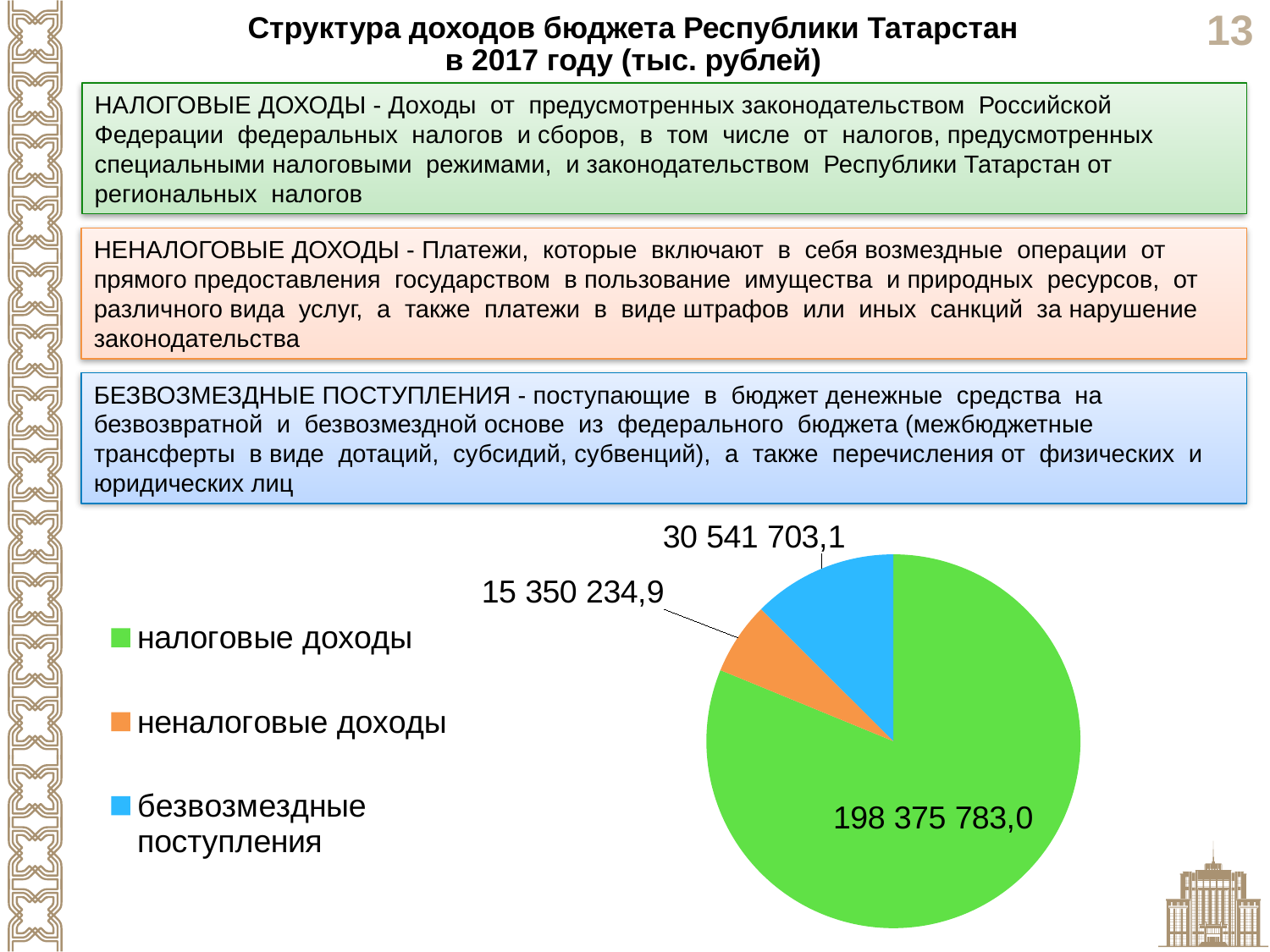
Which category has the smallest slice in the pie chart? неналоговые доходы What is the difference between налоговые доходы and безвозмездные поступления? 167 834 079,9 What kind of chart is shown on the slide? pie chart What is the difference between безвозмездные поступления and неналоговые доходы? 15 191 468,2 How many categories does the pie chart have? 3 Which is larger: безвозмездные поступления or неналоговые доходы? безвозмездные поступления Which category has the largest slice in the pie chart? налоговые доходы What is the total of all three slices in the pie chart? 244 267 721,0 What is the value for неналоговые доходы in the pie chart? 15 350 234,9 What colour is the slice for безвозмездные поступления? blue What is the value for налоговые доходы in the pie chart? 198 375 783,0 What is the value for безвозмездные поступления in the pie chart? 30 541 703,1